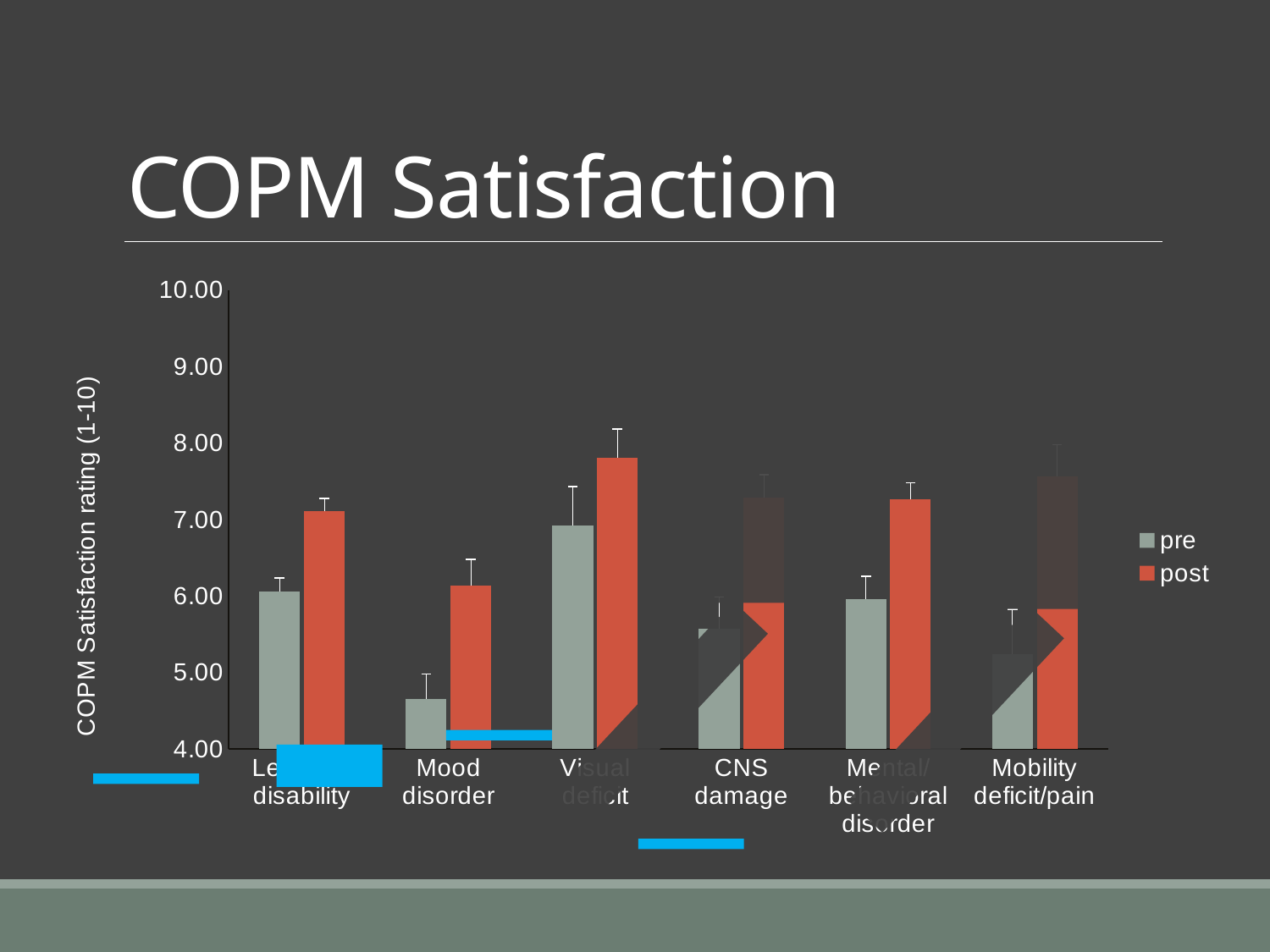
What is the y-axis title of the chart? COPM Satisfaction rating (1-10) For Visual deficit, which is larger, the pre value or the post value? post Is the pre value for Mood disorder greater or less than 5.00? less Is the post value for Visual deficit greater or less than 7.00? greater How many series does the legend list? 2 What kind of chart is shown on the slide? bar chart Which category has the lowest pre value? Mood disorder Which category has the highest pre value? Visual deficit For Mood disorder, which is larger, the pre value or the post value? post How many categories are shown on the x axis? 6 Is the post value for Mental/behavioral disorder greater or less than 7.00? greater What are the two series named in the legend? pre and post